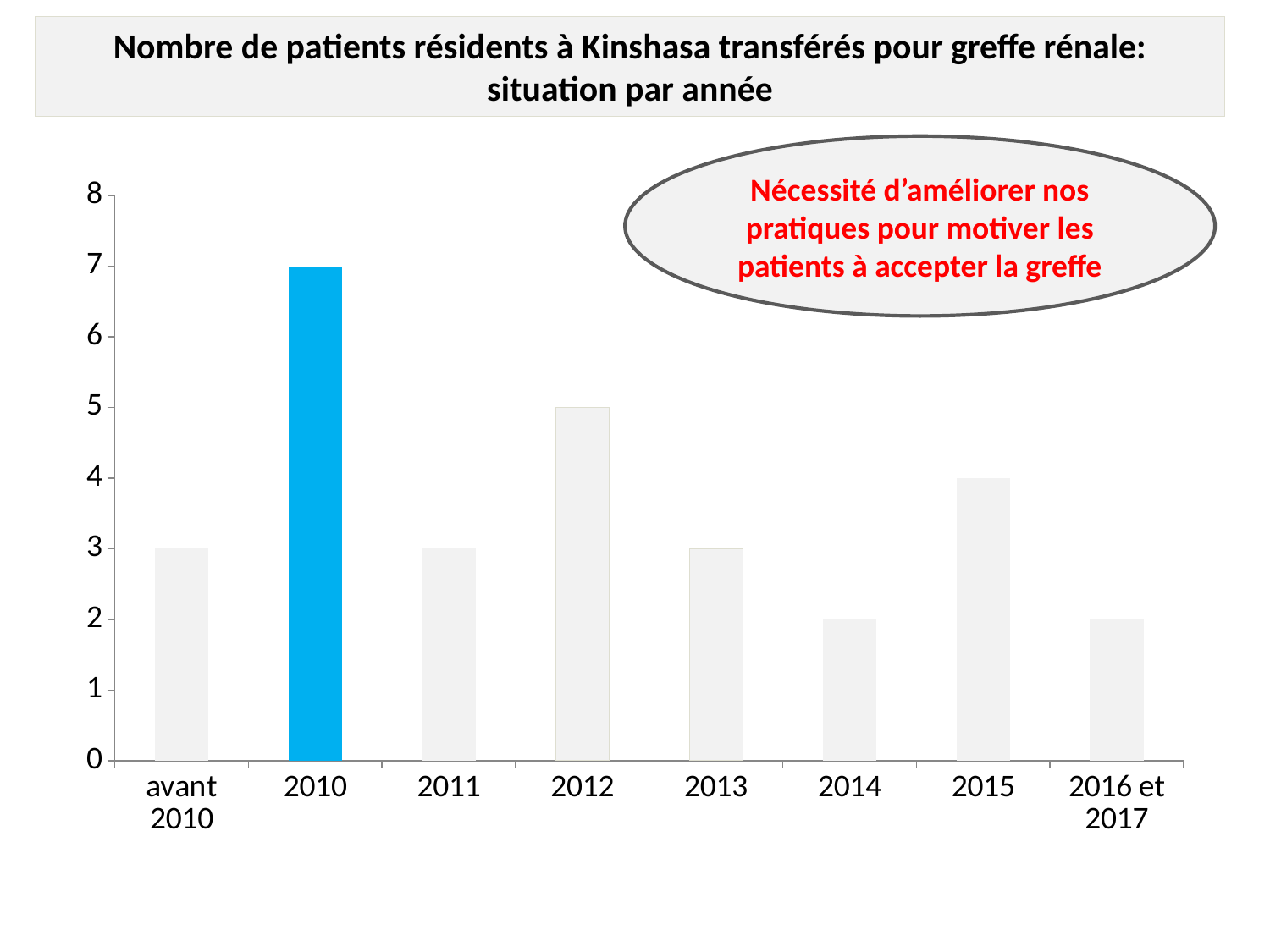
What is the difference between the values for 2010 and 2012? 2 What is the value for 2010? 7 What is the value for 2014? 2 What type of chart is shown on the slide? bar chart How many categories are shown on the x axis? 8 Which bar is highlighted in a different colour (blue) from the others? 2010 Do the values rise or fall from 2012 to 2014? fall What is the value for 2015? 4 Which is larger, the value for 2015 or the value for 2013? 2015 Is the value for 2010 greater or less than 6? greater Which category has the highest value? 2010 What is the value for 2012? 5